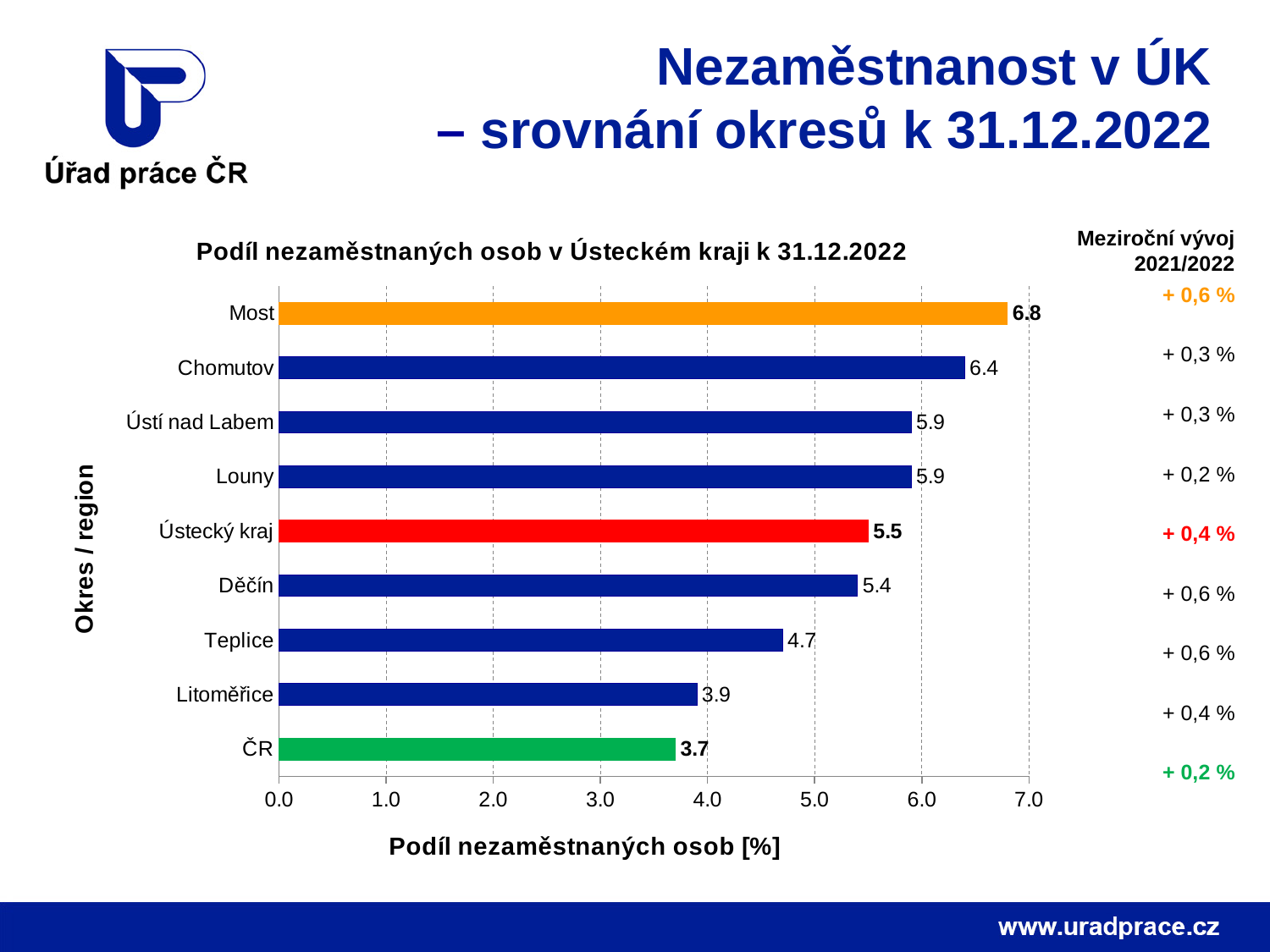
Which category has the highest value? Most How many categories are shown on the chart? 9 What is the title of the chart? Podíl nezaměstnaných osob v Ústeckém kraji k 31.12.2022 What is the value for Most? 6.8 What is the value for Teplice? 4.7 Which is larger, the value for Děčín or the value for Teplice? Děčín Which category has the lowest value? ČR What is the difference between the values for Most and ČR? 3.1 What is the difference between the values for Chomutov and Litoměřice? 2.5 What is the value for Ústecký kraj? 5.5 What kind of chart is shown on the slide? bar chart What is the value for ČR? 3.7